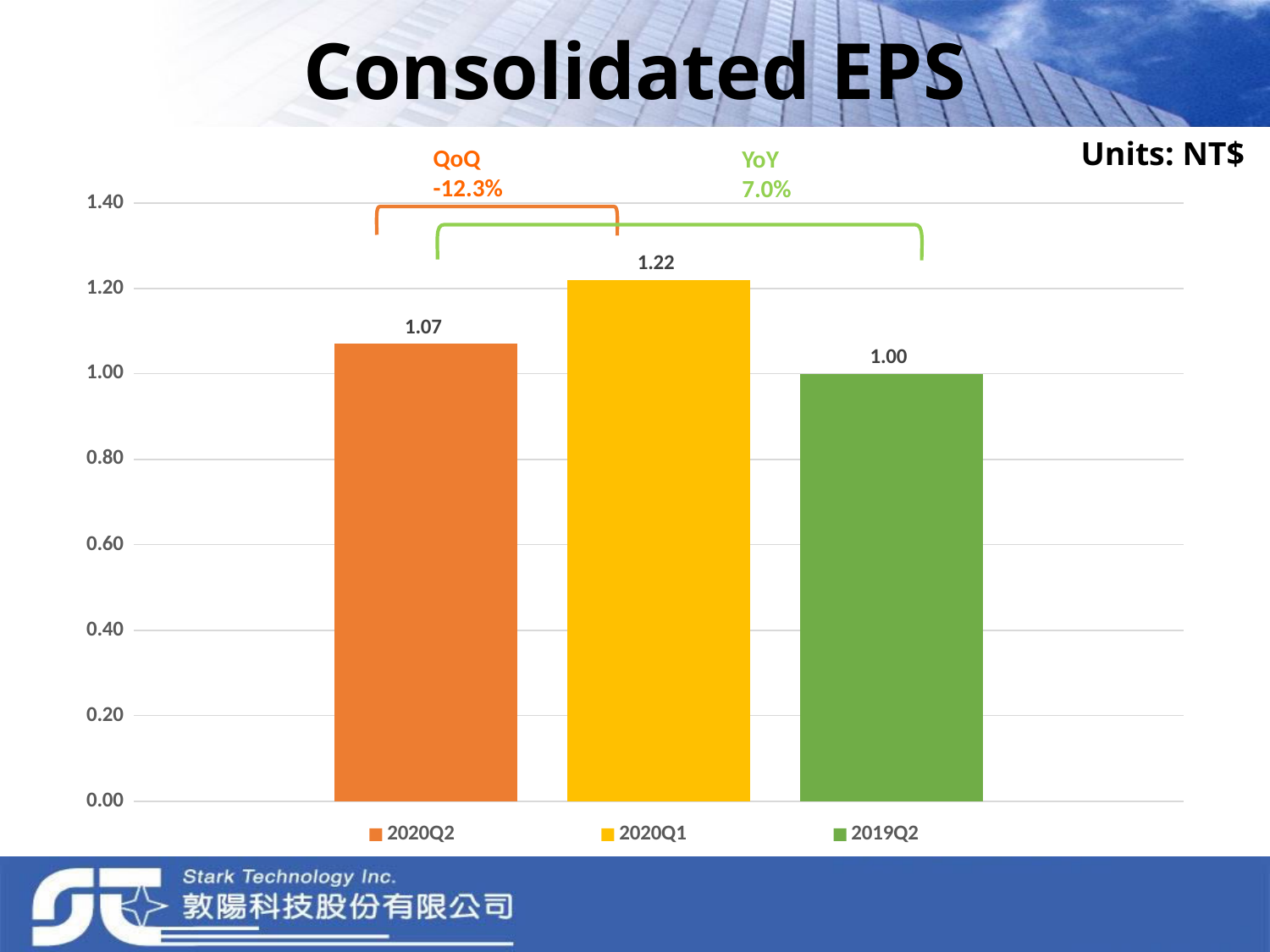
What is the consolidated EPS for 2020Q2? 1.07 How many periods are shown in the chart? 3 How many entries does the legend list? 3 What is the consolidated EPS for 2020Q1? 1.22 Which period has the lowest consolidated EPS? 2019Q2 What is the difference between the EPS for 2020Q1 and 2020Q2? 0.15 What is the consolidated EPS for 2019Q2? 1.00 What is the difference between the EPS for 2020Q2 and 2019Q2? 0.07 Which period has the highest consolidated EPS? 2020Q1 What kind of chart is shown on the slide? Bar chart Which is larger, the EPS for 2020Q2 or 2019Q2? 2020Q2 What QoQ change is annotated on the chart? -12.3%